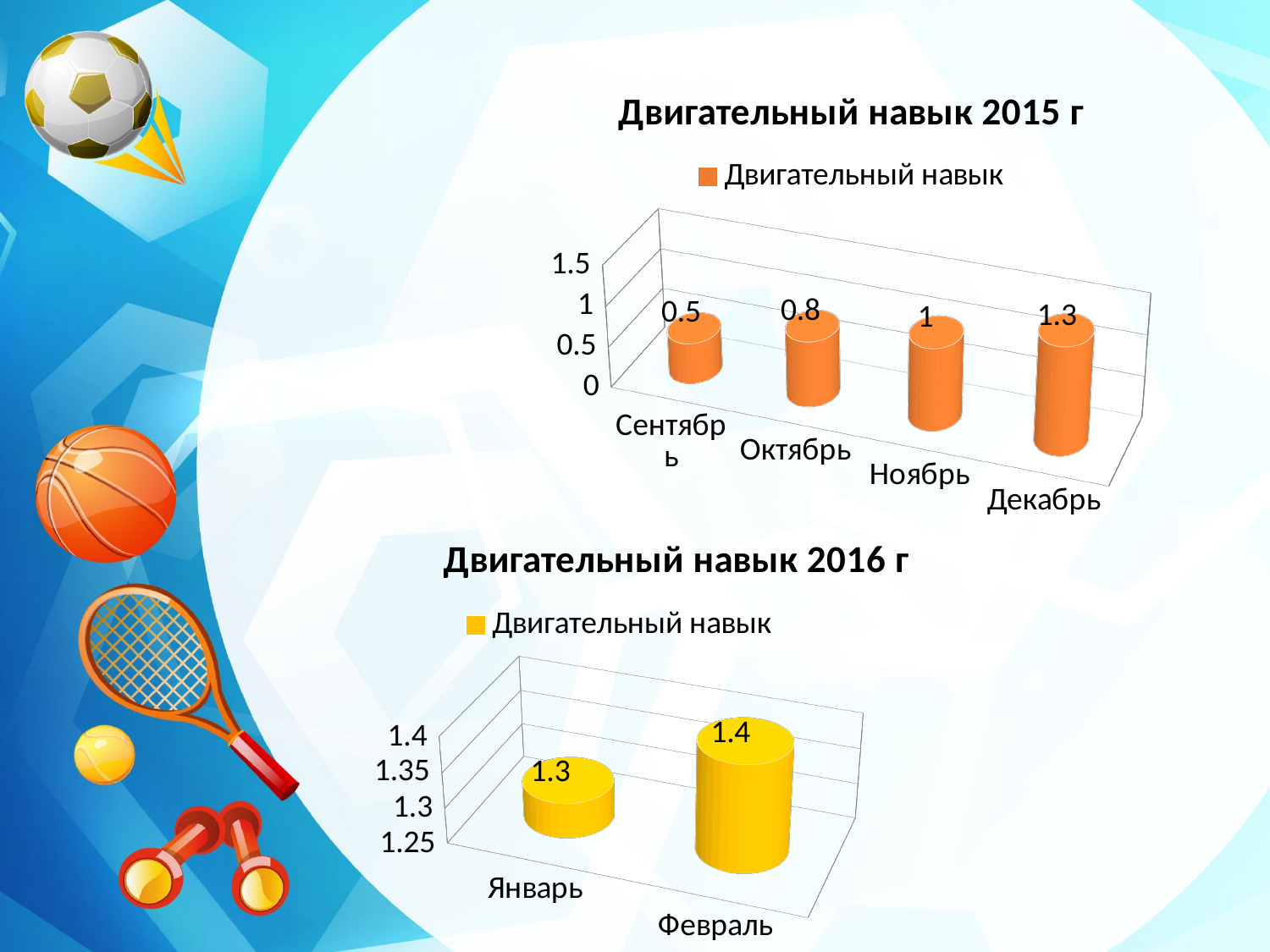
In the chart titled 'Двигательный навык 2015 г', how many months are shown on the x axis? 4 How many series does the legend of the chart titled 'Двигательный навык 2015 г' list? 1 In the chart titled 'Двигательный навык 2015 г', what is the value for Октябрь? 0.8 In the chart titled 'Двигательный навык 2015 г', which month has the lowest value? Сентябрь In the chart titled 'Двигательный навык 2015 г', what is the difference between the values for Декабрь and Сентябрь? 0.8 What kind of chart is the chart titled 'Двигательный навык 2016 г'? bar chart In the chart titled 'Двигательный навык 2015 г', do the values rise or fall from Сентябрь to Декабрь? rise In the chart titled 'Двигательный навык 2016 г', what is the value for Февраль? 1.4 In the chart titled 'Двигательный навык 2016 г', what is the value for Январь? 1.3 In the chart titled 'Двигательный навык 2015 г', which month has the highest value? Декабрь In the chart titled 'Двигательный навык 2015 г', what is the value for Декабрь? 1.3 In the chart titled 'Двигательный навык 2016 г', which month has the larger value, Январь or Февраль? Февраль